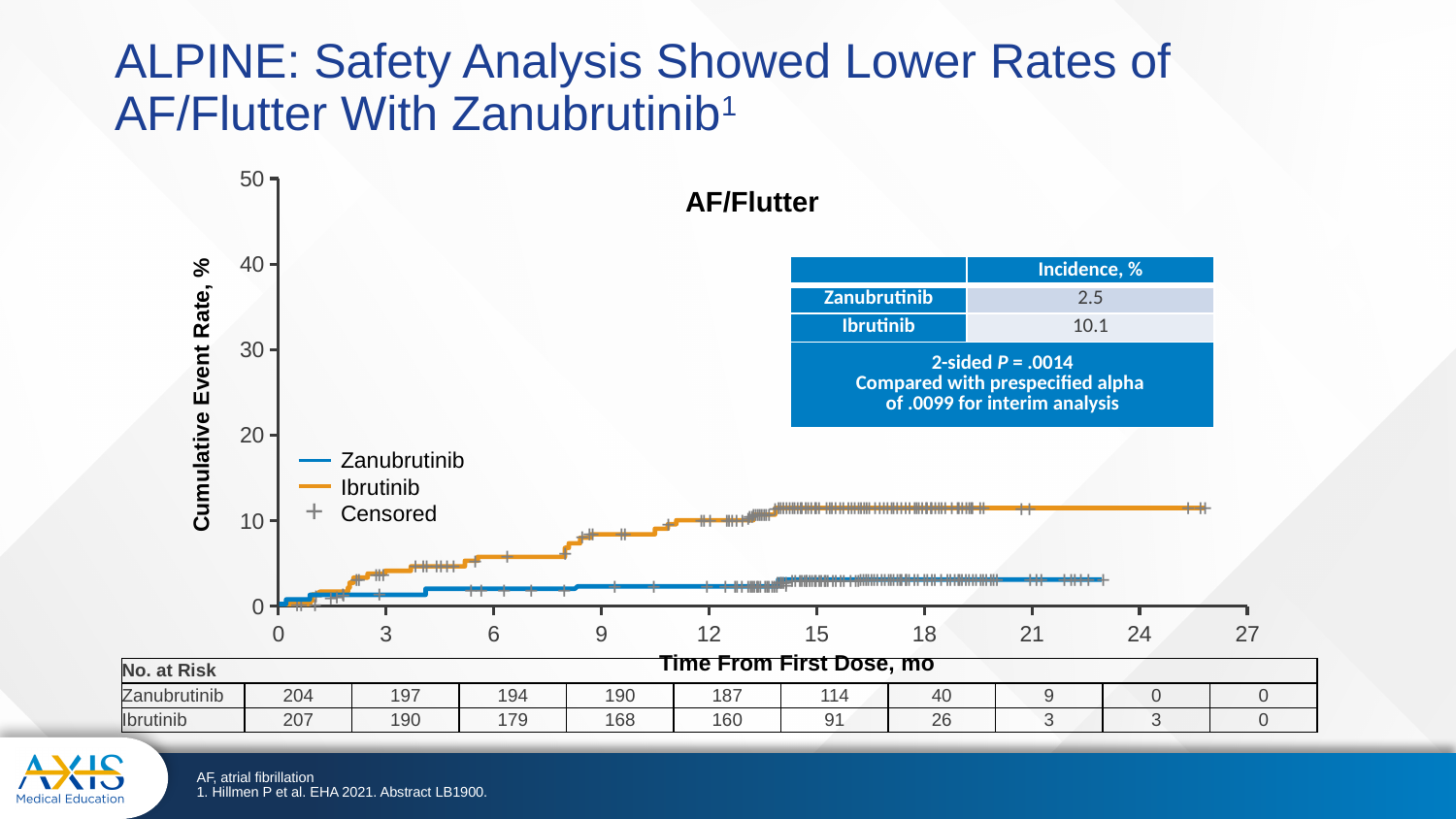
How many entries does the chart legend list? 3 What is the incidence (%) of AF/Flutter for Ibrutinib shown in the inset table? 10.1 How many Ibrutinib patients were at risk at 12 months according to the No. at Risk table? 160 What is the incidence (%) of AF/Flutter for Zanubrutinib shown in the inset table? 2.5 Is the cumulative event rate for Zanubrutinib at 21 months greater or less than 10%? less What is the 2-sided P value shown on the chart? .0014 Do the cumulative event rate curves rise or fall over time from first dose? Rise What is the title of the chart? AF/Flutter What kind of chart is shown on the slide? Line chart Which treatment curve shows the higher cumulative event rate, Zanubrutinib or Ibrutinib? Ibrutinib Is the cumulative event rate for Ibrutinib at 24 months greater or less than 10%? greater What is the difference in incidence (%) between Ibrutinib and Zanubrutinib? 7.6